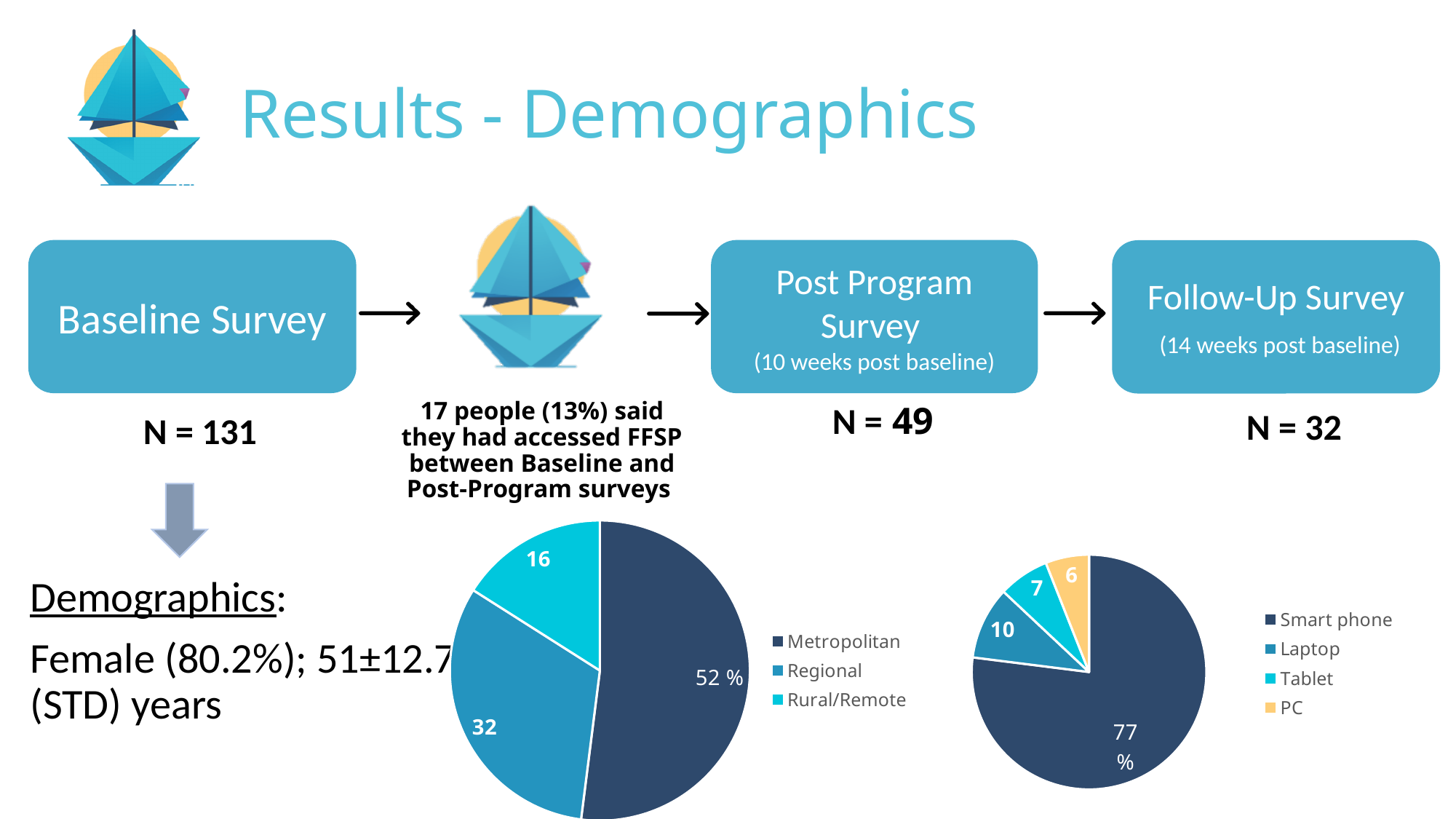
How many categories does the legend of the right pie chart list? 4 In the right pie chart, what is the value shown for Laptop? 10 In the left pie chart, what is the value shown for Rural/Remote? 16 In the left pie chart, which category has the smallest slice? Rural/Remote How many categories does the legend of the left pie chart list? 3 In the left pie chart, which category has the largest slice? Metropolitan In the right pie chart, which category has the smallest slice? PC What type of chart is the left chart on the slide? Pie chart In the right pie chart, what is the value shown for PC? 6 In the left pie chart, what is the value shown for Regional? 32 In the left pie chart, what is the value shown for Metropolitan? 52 % In the right pie chart, what is the value shown for Smart phone? 77 %